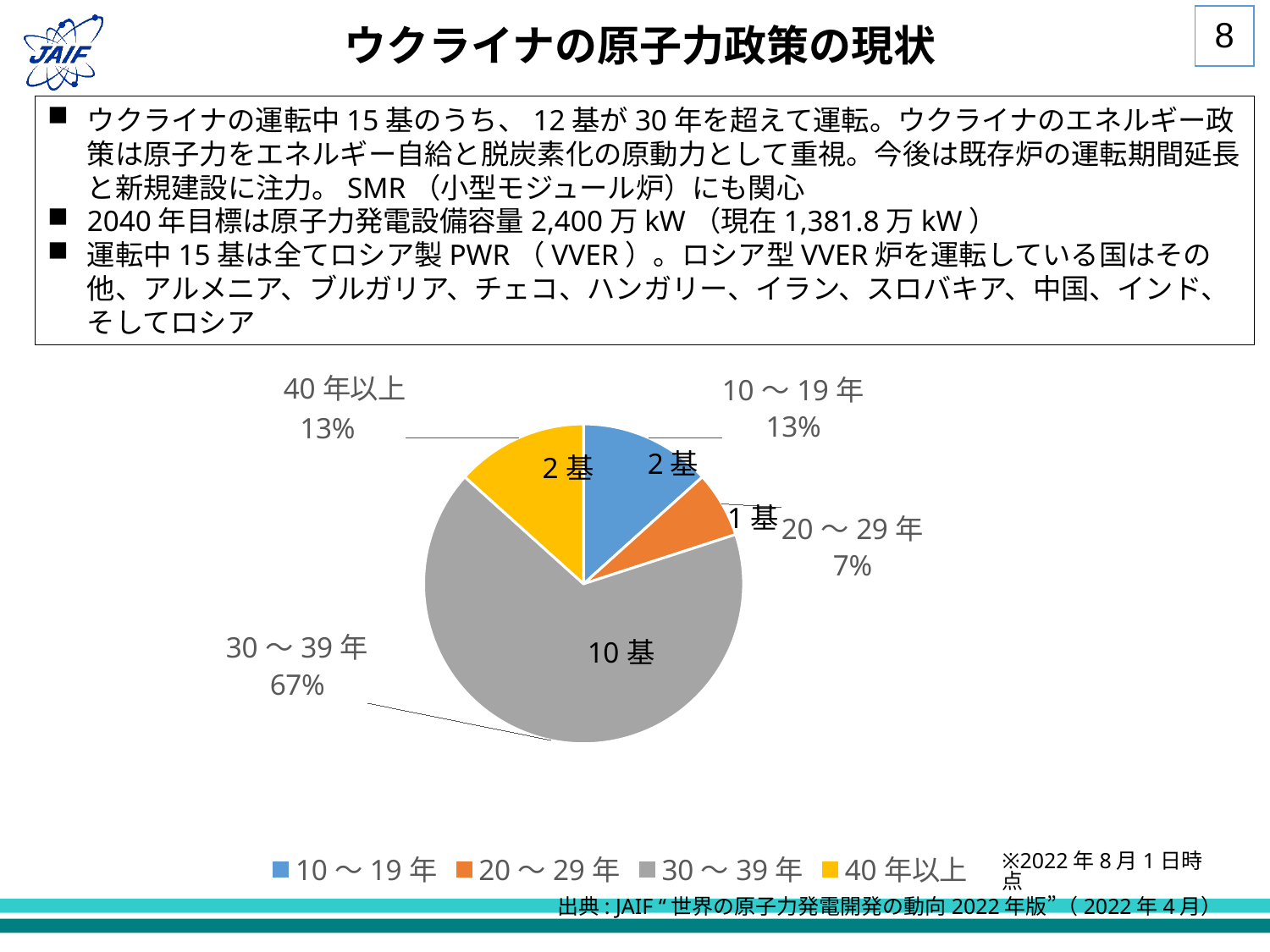
How many reactors are in the 30～39年 category? 10基 How many entries does the legend list? 4 How many reactors are in the 20～29年 category? 1基 What colour is the 40年以上 slice in the pie chart? yellow Which category has the largest slice of the pie? 30～39年 What share of the pie does the 30～39年 slice represent? 67% Which category has the smallest slice of the pie? 20～29年 What percentage is shown for the 40年以上 slice? 13% What kind of chart is shown on the slide? pie chart How many categories does the pie chart have? 4 What is the difference in the number of reactors between the 30～39年 and 10～19年 categories? 8基 Which has more reactors, the 10～19年 category or the 20～29年 category? 10～19年